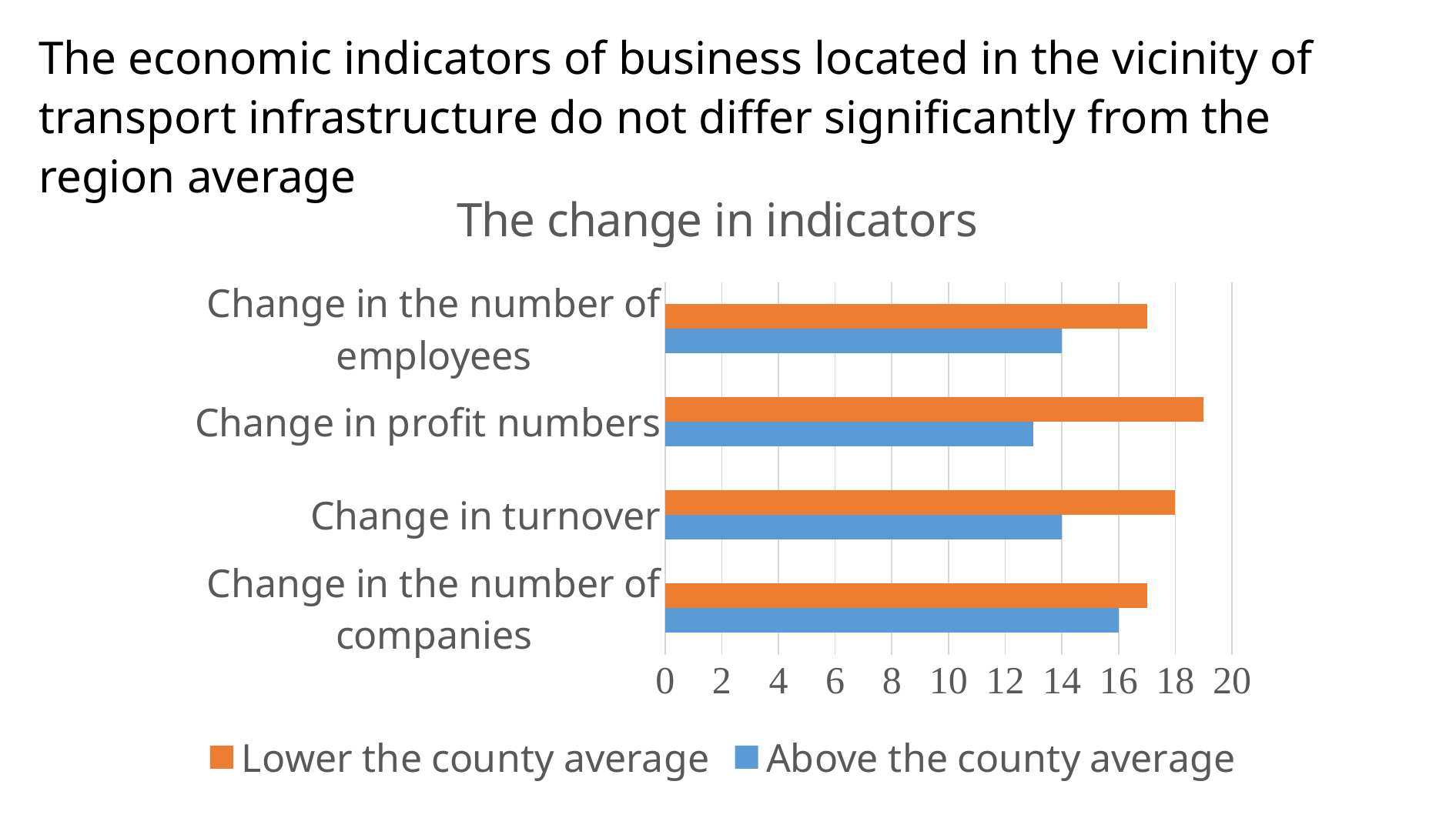
For 'Change in profit numbers', which series has the larger value: 'Lower the county average' or 'Above the county average'? Lower the county average What is the value of 'Above the county average' for 'Change in turnover'? 14 Which colour represents 'Above the county average' in the chart? Blue How many series does the legend list? 2 What is the title of the chart? The change in indicators How many categories are shown on the chart? 4 What is the value of 'Above the county average' for 'Change in the number of companies'? 16 Is the value of 'Above the county average' for 'Change in profit numbers' greater or less than 14? less Is the value of 'Lower the county average' for 'Change in profit numbers' greater or less than 18? greater Which category has the highest value for 'Above the county average'? Change in the number of companies What is the value of 'Lower the county average' for 'Change in turnover'? 18 What kind of chart is shown on the slide? Bar chart